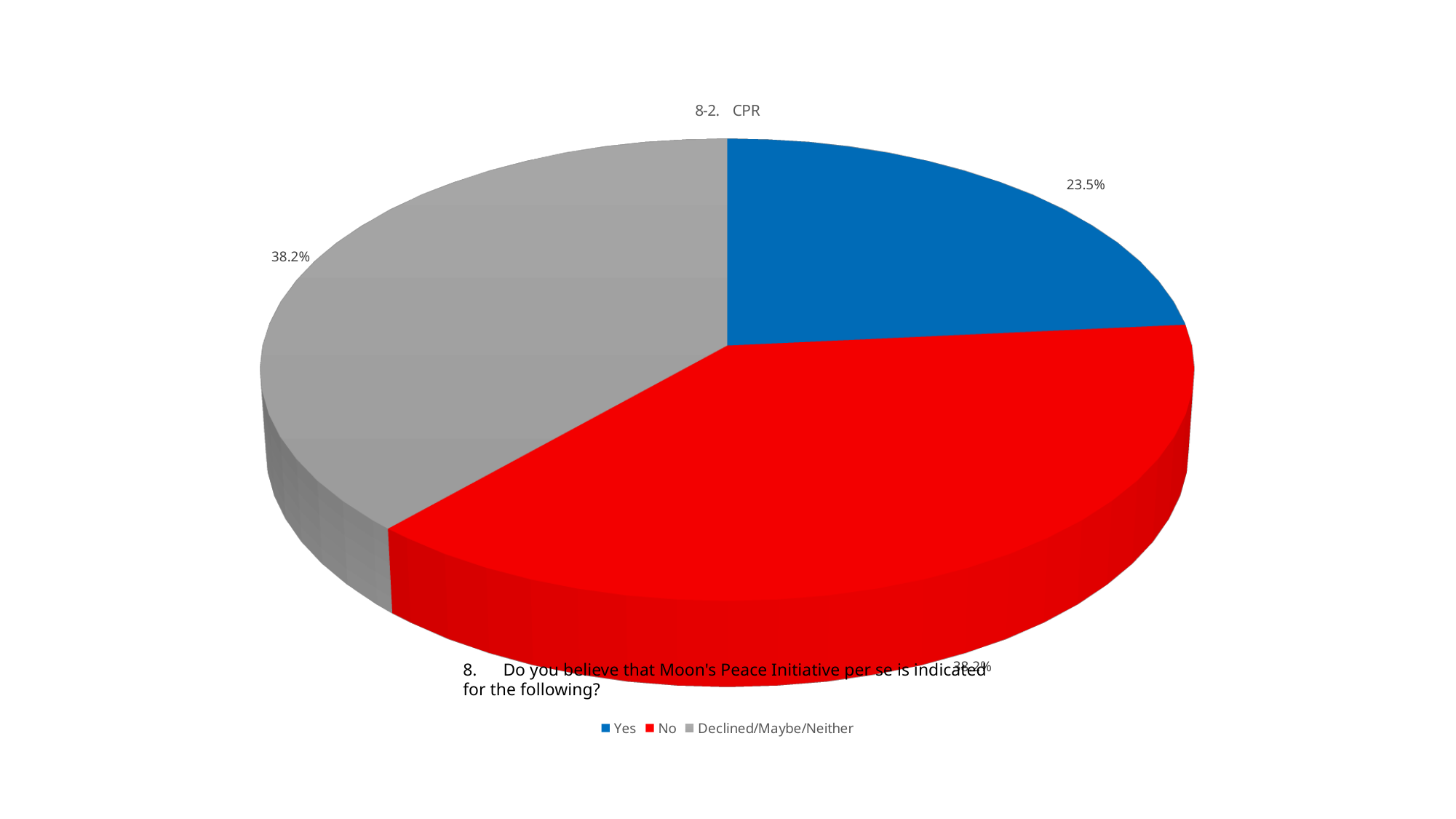
How many slices does the pie chart have? 3 What percentage of the pie is the Declined/Maybe/Neither slice? 38.2% Which is larger, the Yes slice or the Declined/Maybe/Neither slice? Declined/Maybe/Neither How many entries does the legend list? 3 What kind of chart is shown on the slide? pie chart Which category has the smallest slice of the pie? Yes What percentage of the pie is the Yes slice? 23.5% What colour is the Yes slice in the pie chart? blue What percentage of the pie is the No slice? 38.2% What is the title of the chart? 8-2. CPR What is the difference in percentage points between the Declined/Maybe/Neither slice and the Yes slice? 14.7% Which is larger, the No slice or the Yes slice? No